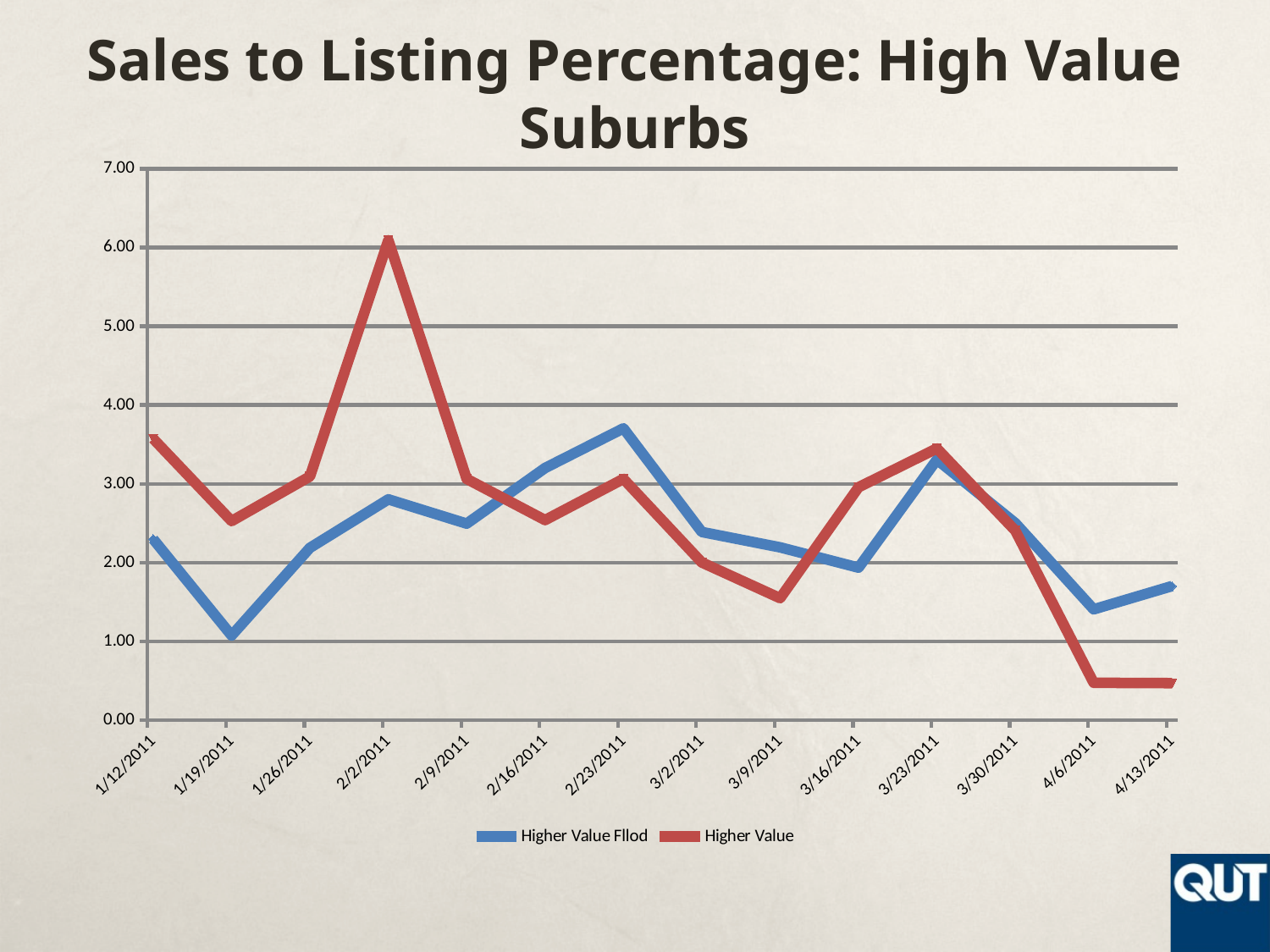
Is the value for Higher Value on 4/6/2011 greater or less than 1.00? less On 2/2/2011, which series has the larger value, Higher Value Fllod or Higher Value? Higher Value What is the title of the chart? Sales to Listing Percentage: High Value Suburbs How many series does the legend list? 2 On which date does the Higher Value series reach its highest point? 2/2/2011 On 2/23/2011, which series has the larger value, Higher Value Fllod or Higher Value? Higher Value Fllod Is the value for Higher Value Fllod on 1/12/2011 greater or less than 2.00? greater How many dates are plotted along the x axis? 14 Is the value for Higher Value on 2/2/2011 greater or less than 6.00? greater What kind of chart is shown on the slide? line chart On which date does the Higher Value Fllod series reach its highest point? 2/23/2011 On which date does the Higher Value Fllod series reach its lowest point? 1/19/2011